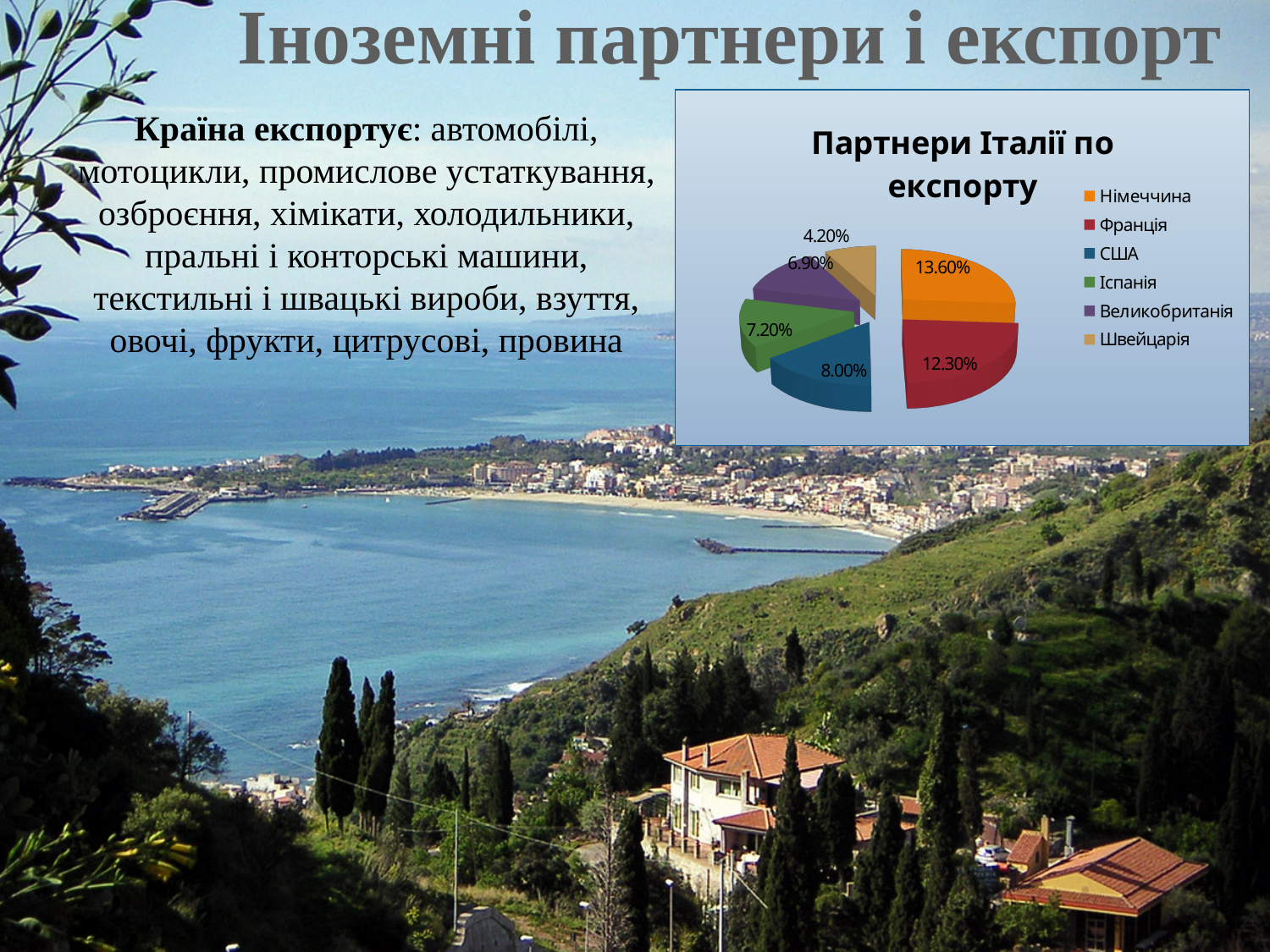
What is the difference between the values for Німеччина and Франція? 1.30% Which partner has the largest slice of the pie? Німеччина Which is larger, the value for Іспанія or the value for Великобританія? Іспанія What is the value shown for Німеччина? 13.60% What kind of chart is shown on the slide? pie chart What is the value shown for Швейцарія? 4.20% Which partner has the smallest slice of the pie? Швейцарія What is the value shown for США? 8.00% What is the title of the chart? Партнери Італії по експорту What is the value shown for Франція? 12.30% Which colour represents США in the chart? blue How many partners are listed in the chart legend? 6